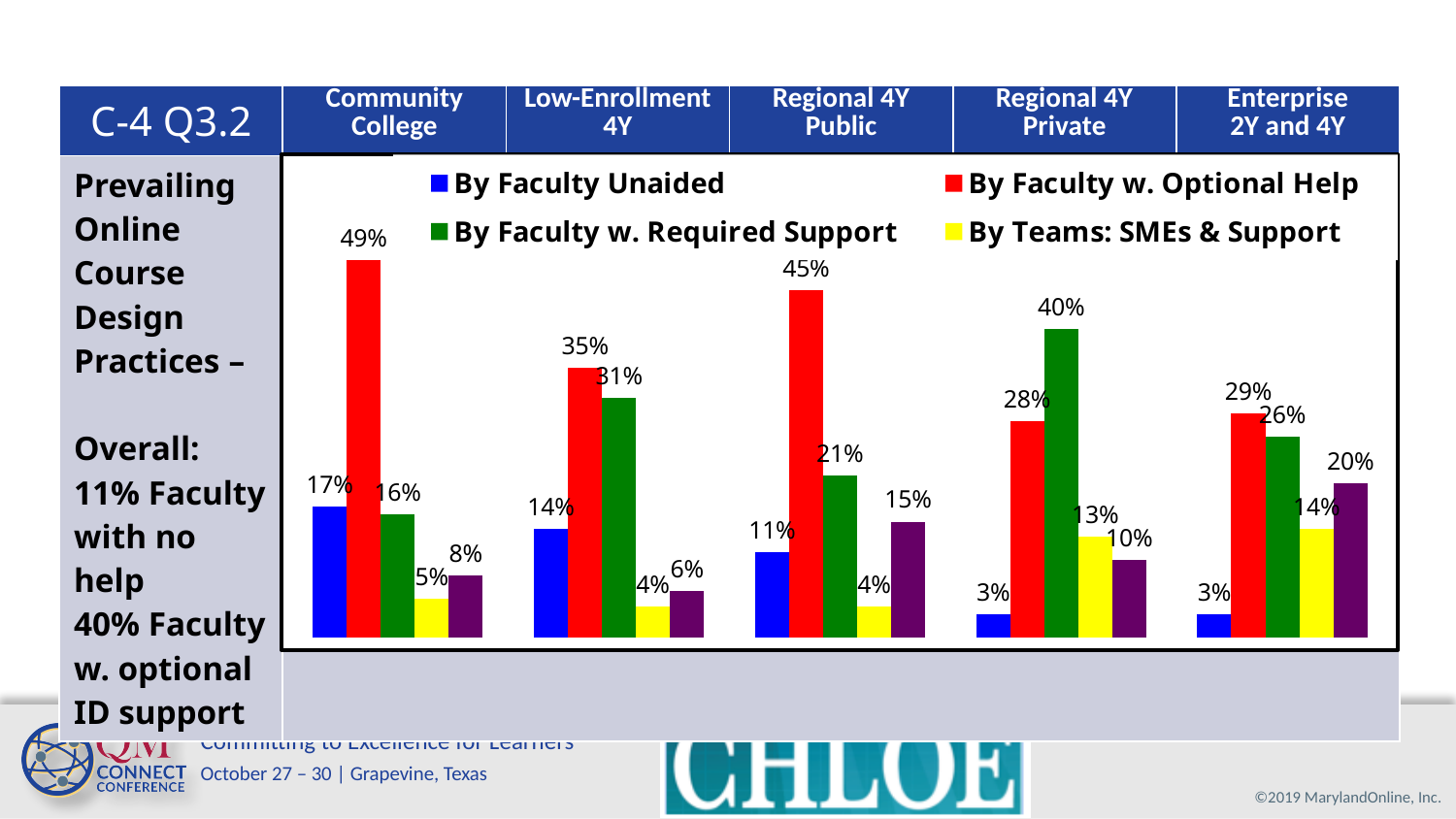
What is the value for By Faculty Unaided for Low-Enrollment 4Y? 14% Which colour represents By Faculty Unaided in the legend? Blue For Regional 4Y Private, which is larger: By Faculty w. Optional Help or By Faculty w. Required Support? By Faculty w. Required Support What kind of chart is shown on the slide? Bar chart How many categories are shown on the x axis? 5 What is the value for By Teams: SMEs & Support for Enterprise 2Y and 4Y? 14% Which category has the highest value for By Faculty w. Optional Help? Community College What is the value for By Faculty w. Required Support for Regional 4Y Private? 40% Which category has the lowest value for By Faculty w. Required Support? Community College What is the difference between By Faculty w. Optional Help and By Faculty w. Required Support for Regional 4Y Public? 24% How many series does the legend list? 4 What is the value for By Faculty w. Optional Help for Community College? 49%